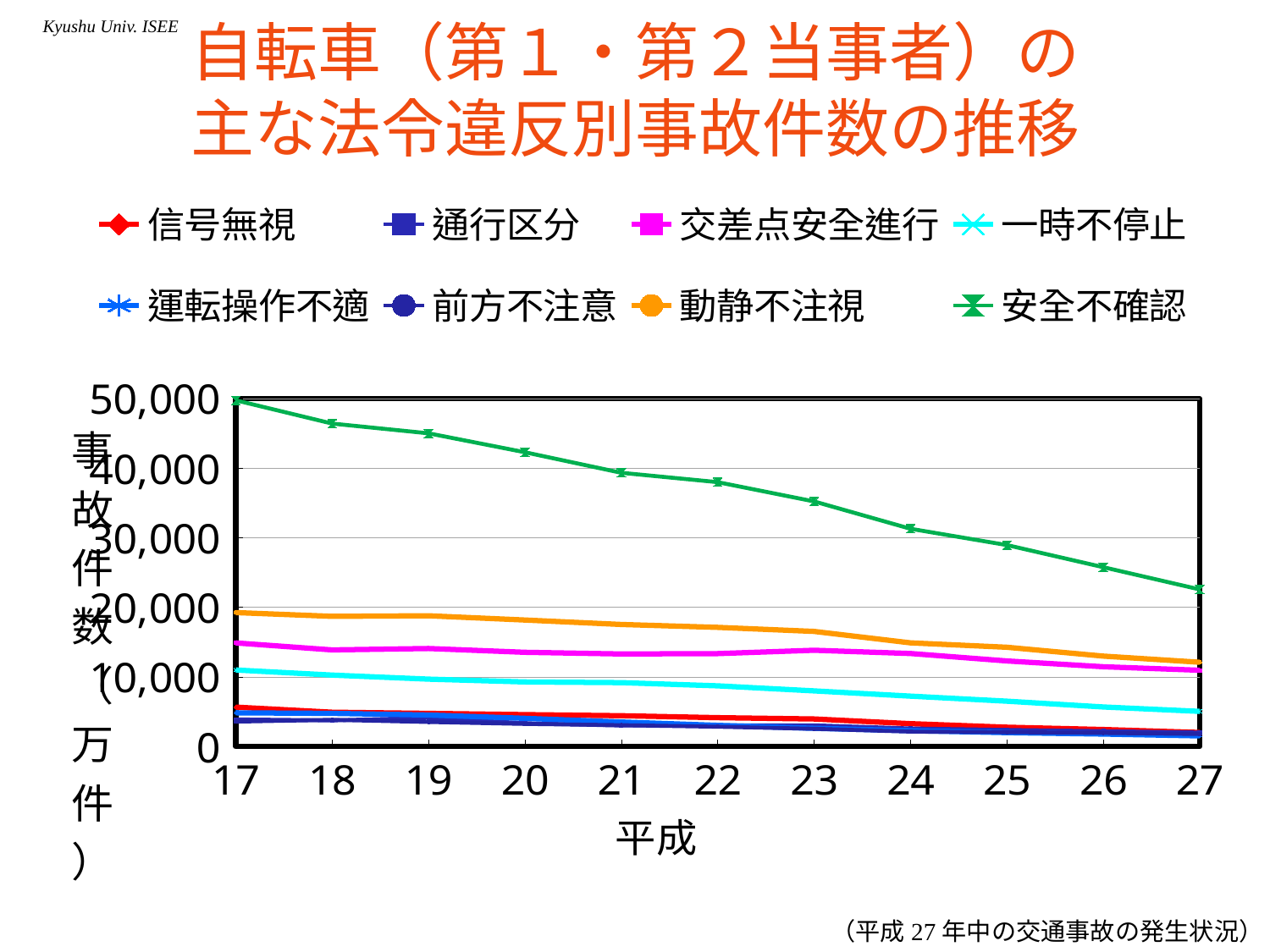
Is the value for 一時不停止 in 平成27 greater or less than 10,000? less Is the value for 動静不注視 in 平成17 greater or less than 10,000? greater What is the label on the x axis of the chart? 平成 In 平成27, which is larger: 交差点安全進行 or 一時不停止? 交差点安全進行 Is the value for 安全不確認 in 平成17 greater or less than 40,000? greater How many series does the legend list? 8 Which series has the highest values across the whole chart? 安全不確認 How many years (points) are shown along the x axis? 11 What kind of chart is shown on the slide? line chart In 平成17, which is larger: 動静不注視 or 交差点安全進行? 動静不注視 Does the 安全不確認 line rise or fall from 平成17 to 平成27? fall